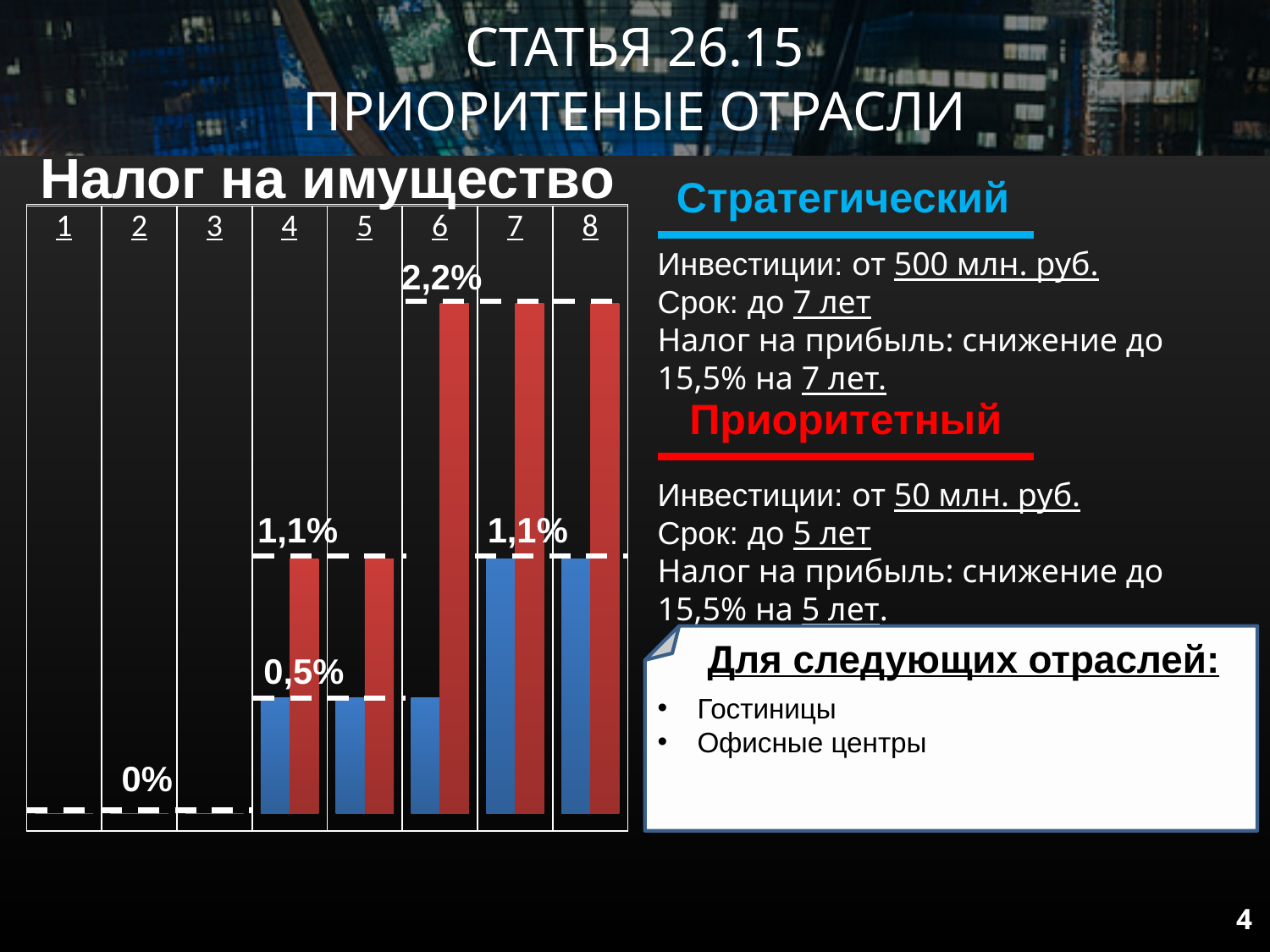
What is the title of the chart on the slide? Налог на имущество What is the value of the red bar for year 6 in the "Налог на имущество" chart? 2,2% Do the values in the "Налог на имущество" chart rise or fall from year 1 to year 8? rise In year 6 of the "Налог на имущество" chart, which bar is taller, the red or the blue? red What is the value of the blue bar for year 7 in the "Налог на имущество" chart? 1,1% What is the value of the blue bar for year 4 in the "Налог на имущество" chart? 0,5% In which year does the red bar in the "Налог на имущество" chart first reach 2,2%? 6 What kind of chart is shown under the heading "Налог на имущество"? bar chart What is the difference between the red bar and the blue bar in year 6 of the "Налог на имущество" chart? 1,7% How many categories (years) are shown on the x axis of the "Налог на имущество" chart? 8 What is the value of the red bar for year 4 in the "Налог на имущество" chart? 1,1% What value is shown for year 2 in the "Налог на имущество" chart? 0%